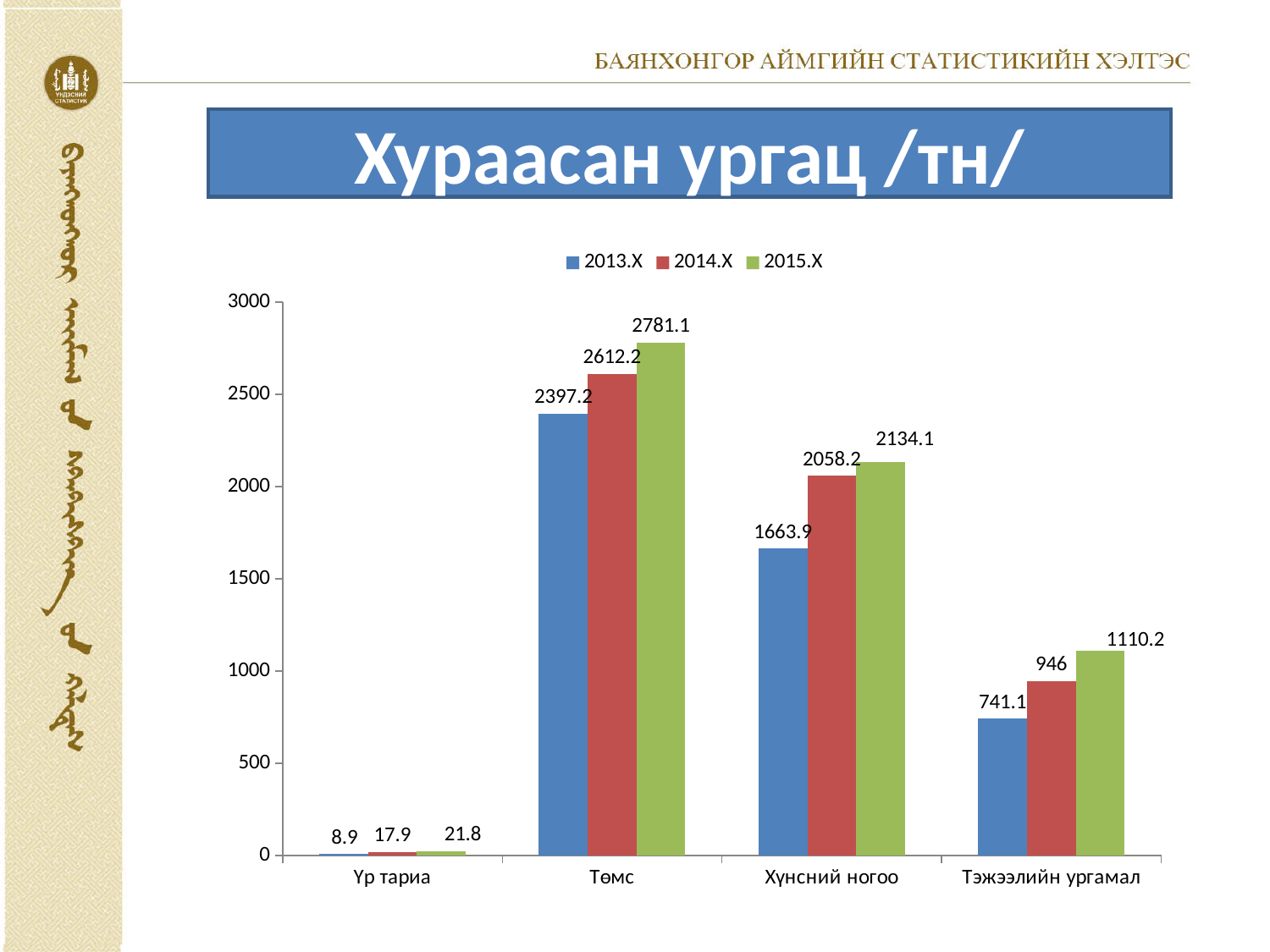
What kind of chart is shown on the slide? Bar chart What is the value for Үр тариа in 2015.X? 21.8 How many series does the legend list? 3 What is the title of the chart? Хураасан ургац /тн/ How many categories are shown on the x axis? 4 Which is larger: the 2014.X value for Хүнсний ногоо or the 2015.X value for Тэжээлийн ургамал? 2014.X value for Хүнсний ногоо Which category has the highest value in 2014.X? Төмс Which category has the lowest value in 2013.X? Үр тариа What is the difference between the 2015.X and 2013.X values for Төмс? 383.9 What is the value for Төмс in 2015.X? 2781.1 What is the value for Хүнсний ногоо in 2013.X? 1663.9 What is the value for Тэжээлийн ургамал in 2014.X? 946